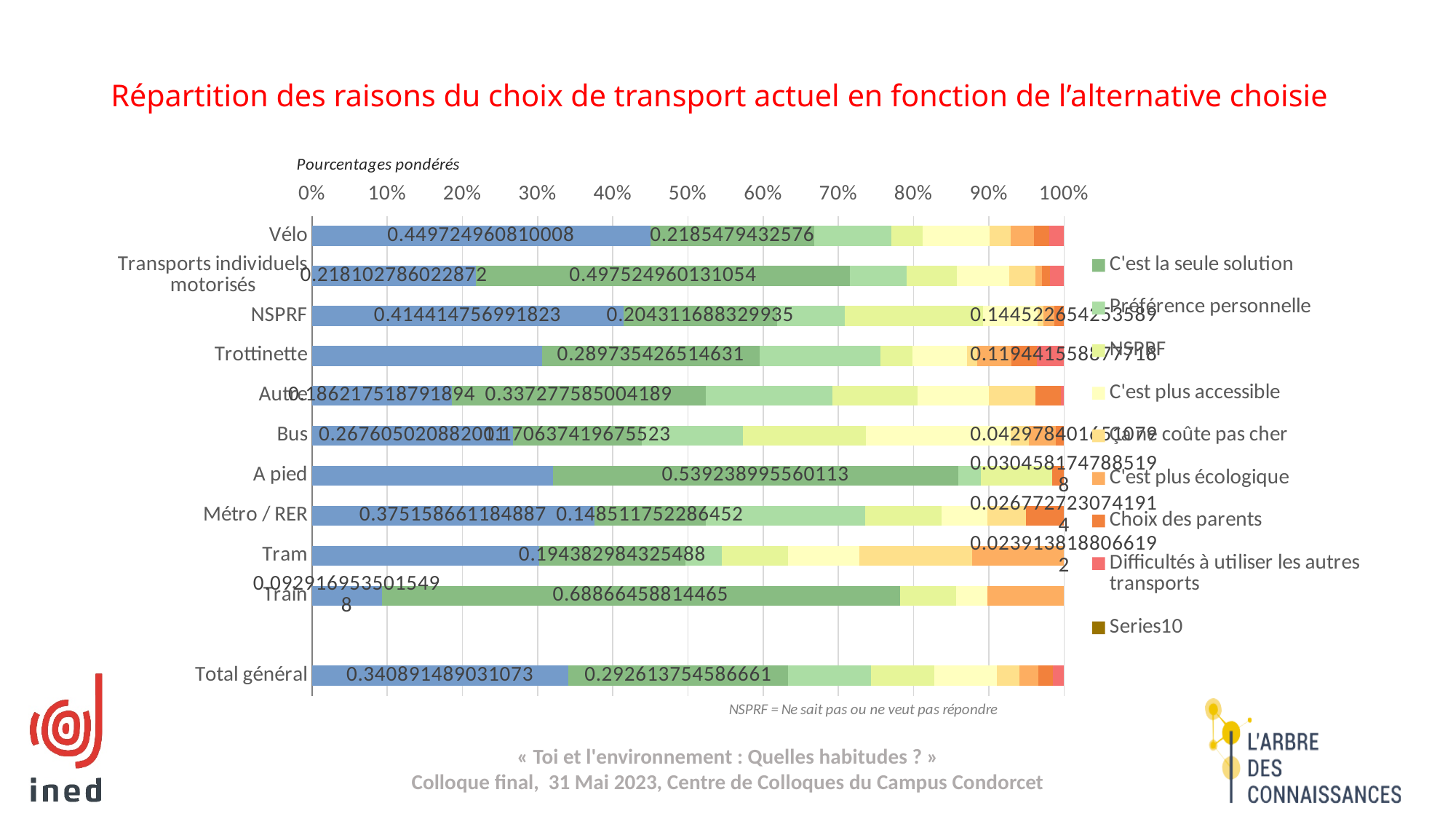
How many entries does the chart's legend list? 9 What is the title of the chart? Répartition des raisons du choix de transport actuel en fonction de l'alternative choisie What is the value printed on the green segment of the Train bar? 0.68866458814465 Which category has the largest first (blue) segment, Vélo or Train? Vélo What is the value printed on the green segment of the Total général bar? 0.292613754586661 What is the value printed on the first (blue) segment of the Métro / RER bar? 0.375158661184887 What is the value printed on the first (blue) segment of the Vélo bar? 0.449724960810008 What kind of chart is shown on the slide? Stacked bar chart How many transport categories are listed on the vertical axis of the chart? 11 Which category has the smallest first (blue) segment? Train Is the first (blue) segment of the Trottinette bar greater or less than 20%? greater What is the value printed on the green segment of the A pied bar? 0.539238995560113